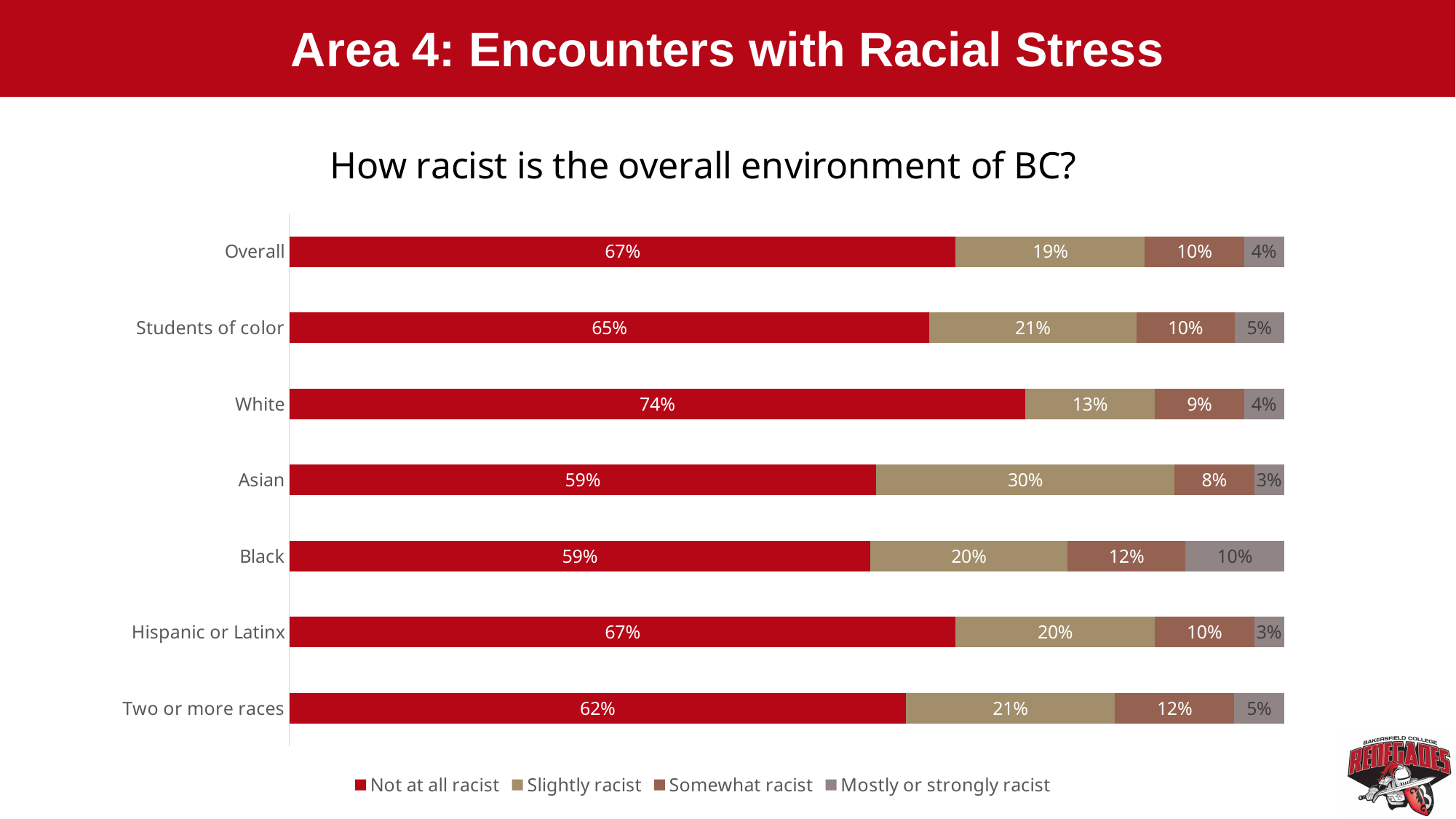
Which group has the lowest "Slightly racist" percentage? White What percentage of White respondents rated the overall environment of BC as "Not at all racist"? 74% What percentage of Black respondents rated the environment as "Mostly or strongly racist"? 10% What is the difference between the "Not at all racist" percentages for White and Asian respondents? 15% What is the title of the chart? How racist is the overall environment of BC? Which group has the highest "Not at all racist" percentage? White What kind of chart is shown on the slide? Stacked bar chart Which is larger: the "Somewhat racist" percentage for Black respondents or for Hispanic or Latinx respondents? Black What percentage of Asian respondents rated the environment as "Slightly racist"? 30% How many series does the legend list? 4 How many groups (categories) are shown on the chart? 7 Which group has the highest "Mostly or strongly racist" percentage? Black